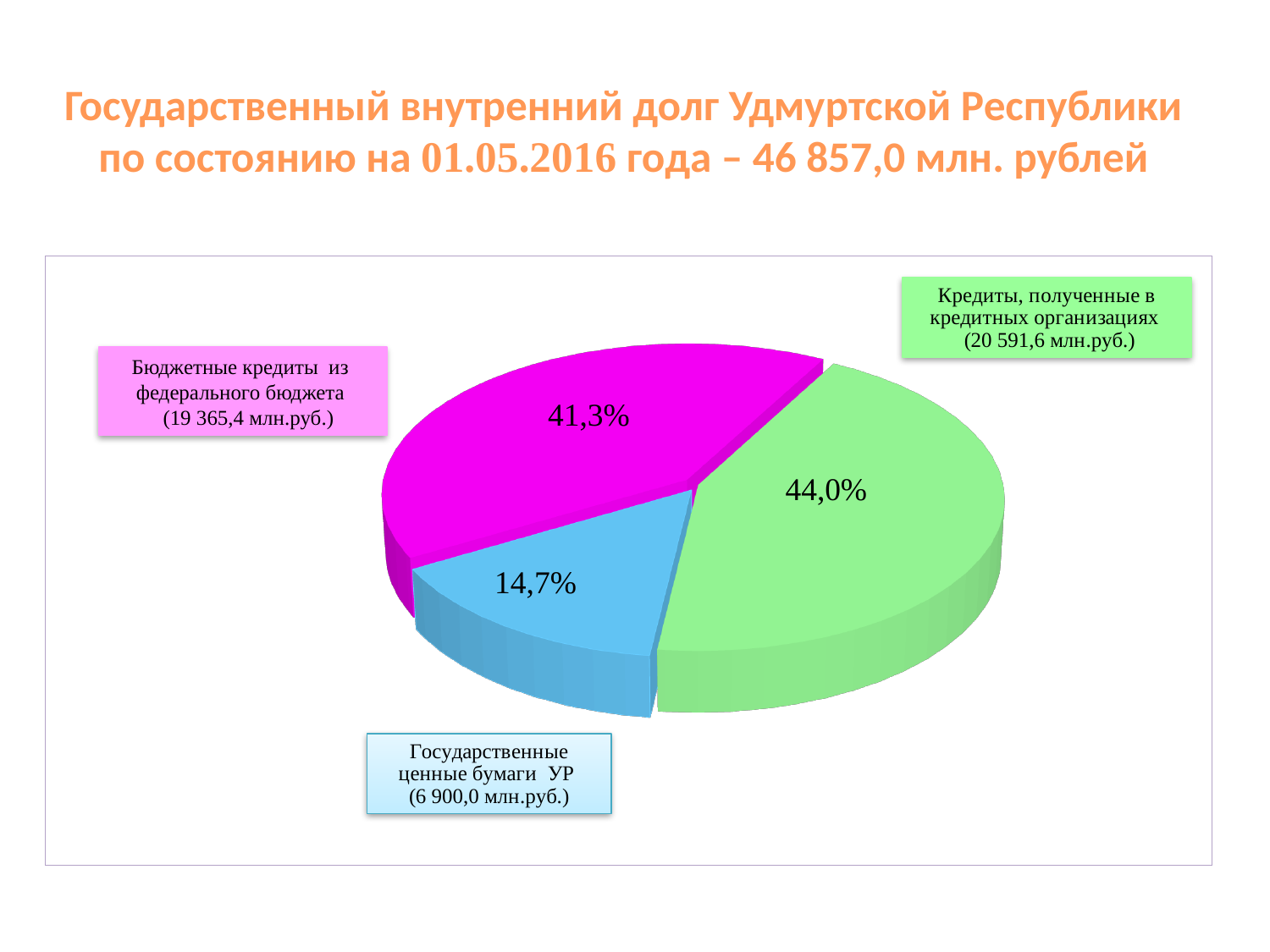
What share of the pie is labelled for Кредиты, полученные в кредитных организациях? 44,0% What is the difference in percentage points between the shares of Кредиты, полученные в кредитных организациях and Государственные ценные бумаги УР? 29,3% What share of the pie is labelled for Государственные ценные бумаги УР? 14,7% What amount in млн.руб. is shown for Кредиты, полученные в кредитных организациях? 20 591,6 млн.руб. Which category has the largest share of the pie? Кредиты, полученные в кредитных организациях What amount in млн.руб. is shown for Государственные ценные бумаги УР? 6 900,0 млн.руб. What amount in млн.руб. is shown for Бюджетные кредиты из федерального бюджета? 19 365,4 млн.руб. What type of chart is shown on the slide? Pie chart How many slices does the pie chart have? 3 What colour is the slice for Бюджетные кредиты из федерального бюджета? Magenta What share of the pie is labelled for Бюджетные кредиты из федерального бюджета? 41,3% Which category has the smallest share of the pie? Государственные ценные бумаги УР